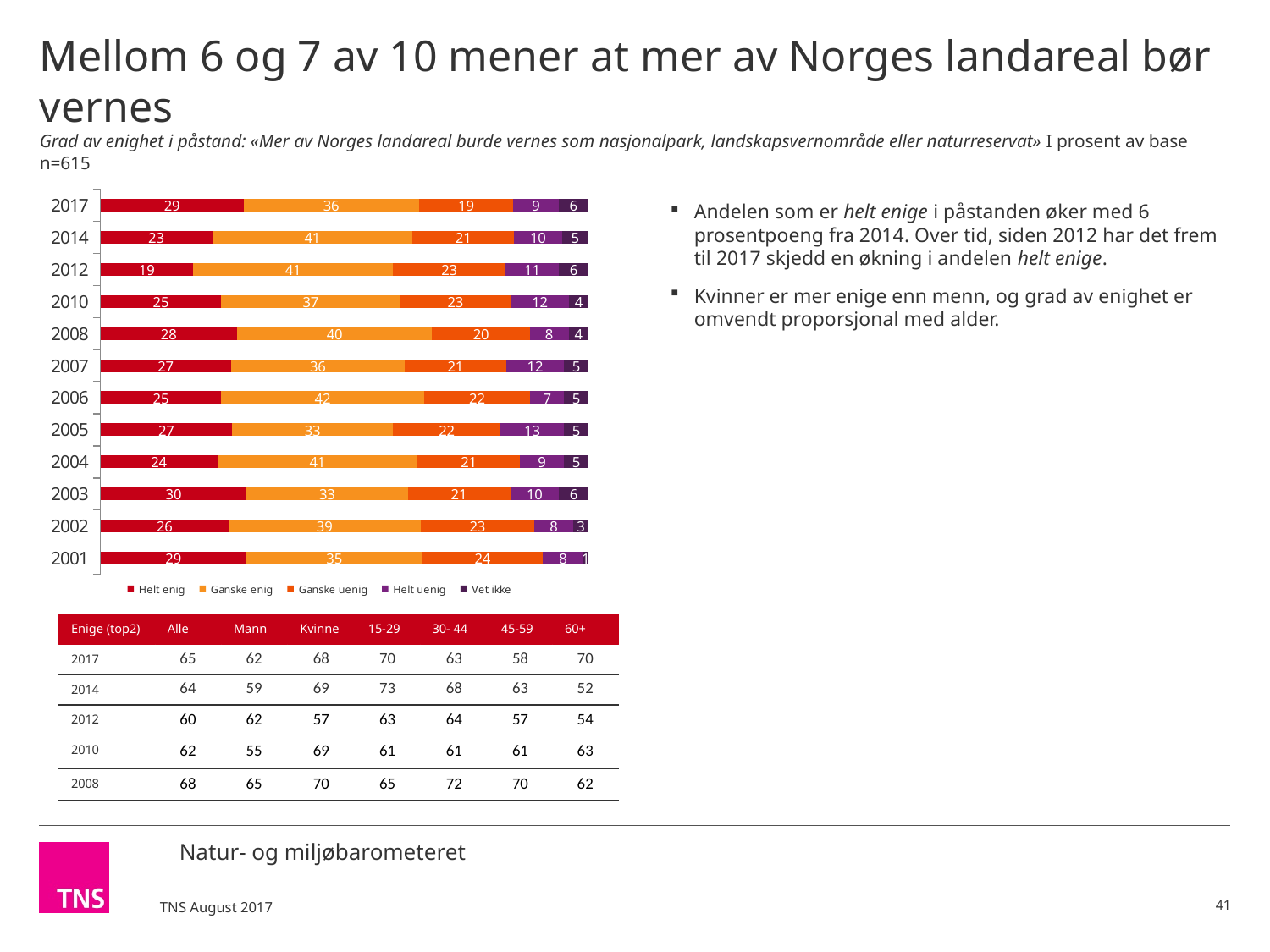
What is the total of the stacked bar for 2017? 99 What kind of chart is shown on the slide? Stacked bar chart What is the value for Vet ikke in 2001? 1 Which year has the highest value for Helt enig? 2003 How many series does the legend list? 5 What is the value for Helt enig in 2017? 29 How many years are shown in the chart? 12 What is the value for Ganske enig in 2006? 42 Which year has the highest value for Helt uenig? 2005 Which year has the lowest value for Helt enig? 2012 Which is larger, the Ganske enig value in 2014 or in 2017? 2014 What is the difference between the Helt enig value in 2017 and in 2014? 6